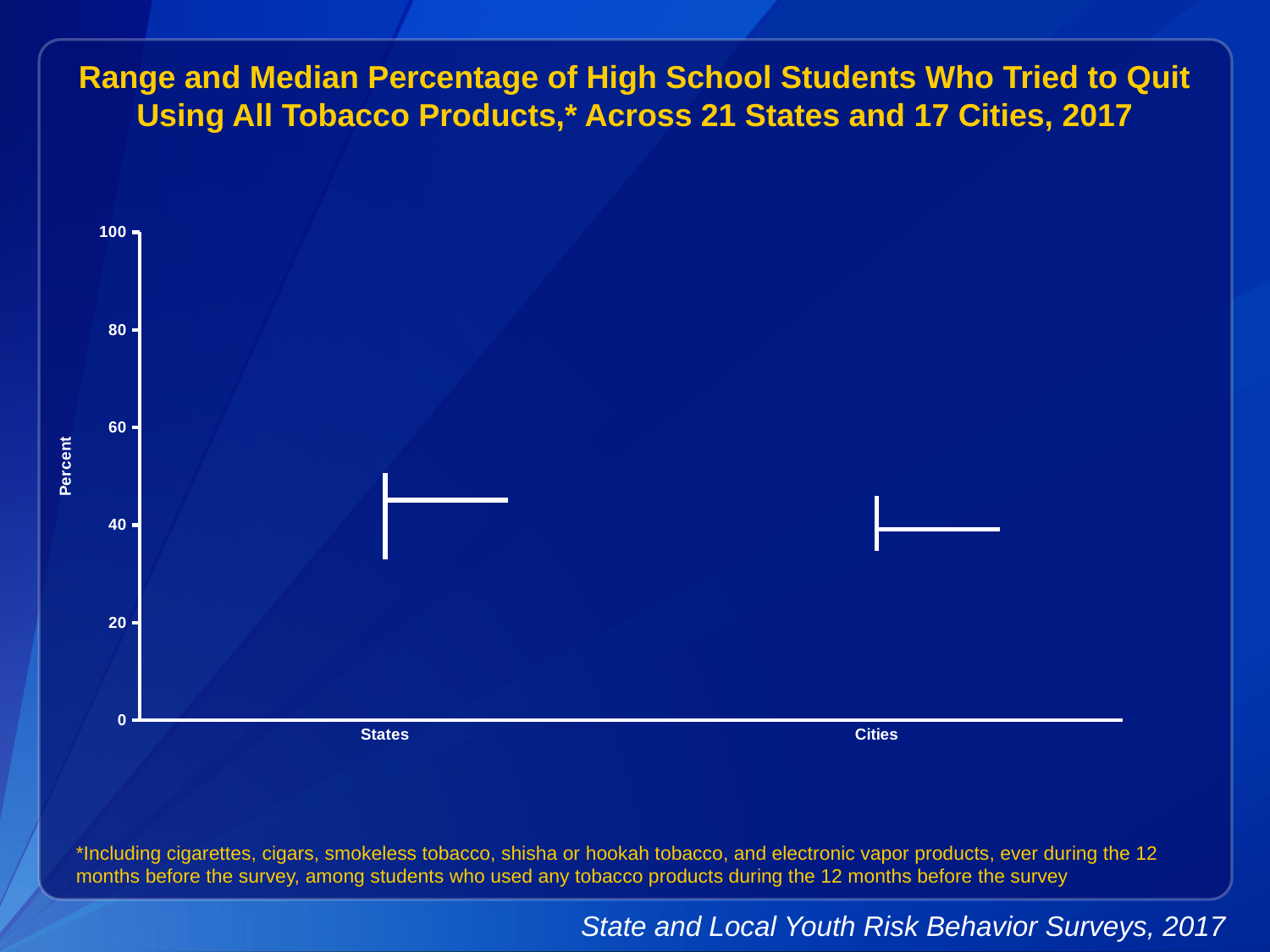
Is the median value for States greater or less than 60? less Is the highest value in the range for States greater or less than 40? greater What is the maximum value shown on the y axis of the chart? 100 Is the median value for Cities greater or less than 20? greater What is the label on the y axis of the chart? Percent Which category has the higher median percentage, States or Cities? States How many categories are shown on the x axis of the chart? 2